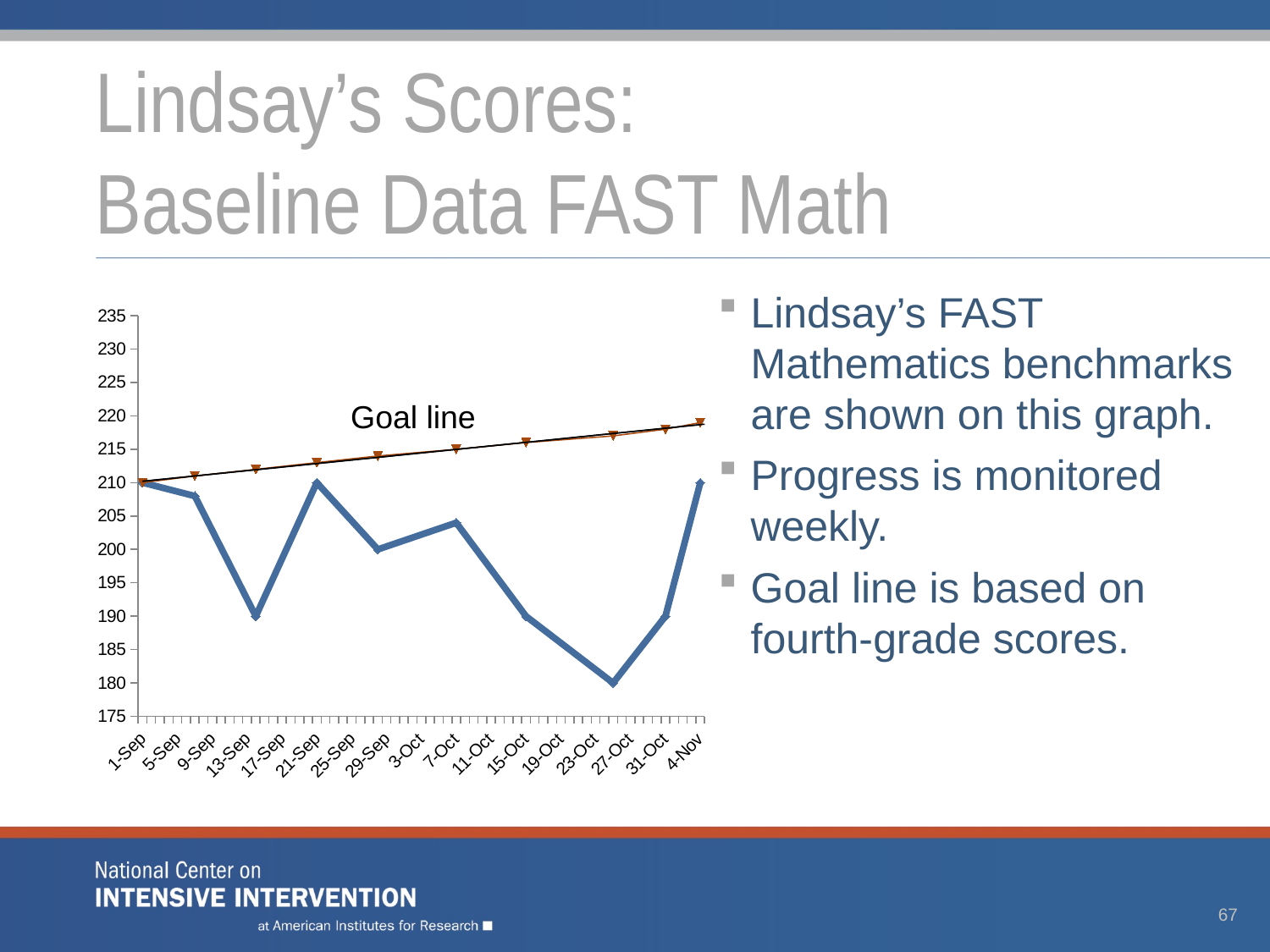
How many date labels are shown on the chart's horizontal axis? 17 What is the text label printed on the chart next to the upper line? Goal line Does the goal line rise or fall from left to right across the chart? Rises Is the lowest point of Lindsay's score line greater or less than 185? less What type of chart is shown on the slide? Line chart What is the first date label on the chart's horizontal axis? 1-Sep What is the highest value shown on the chart's vertical axis? 235 Is the final value of the goal line greater or less than 215? greater At the right end of the chart, which is higher: the goal line or Lindsay's score line? Goal line Is the first point of Lindsay's score line (at 1-Sep) greater or less than 205? greater What is the last date label on the chart's horizontal axis? 4-Nov